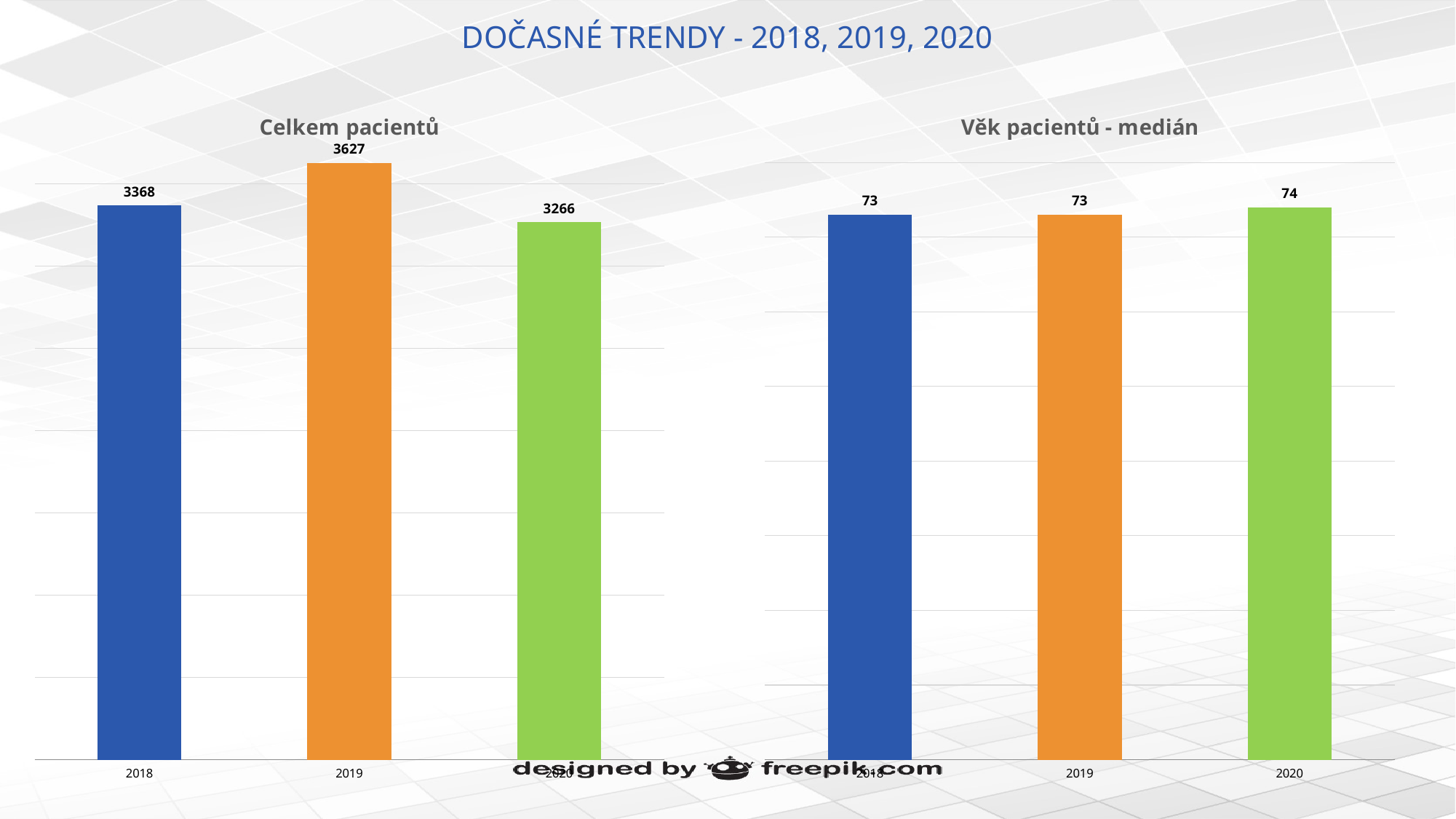
In the 'Celkem pacientů' chart, which year has the highest value? 2019 In the 'Věk pacientů - medián' chart, what is the difference between the 2020 and 2019 values? 1 In the 'Celkem pacientů' chart, which is larger, the value for 2018 or the value for 2020? 2018 In the 'Celkem pacientů' chart, what is the value for 2018? 3368 In the 'Celkem pacientů' chart, what is the value for 2019? 3627 In the 'Celkem pacientů' chart, which year has the lowest value? 2020 How many bars are in the 'Věk pacientů - medián' chart? 3 In the 'Věk pacientů - medián' chart, what is the value for 2018? 73 What is the title of the chart on the right side of the slide? Věk pacientů - medián In the 'Věk pacientů - medián' chart, what is the value for 2020? 74 What type of chart is the 'Celkem pacientů' chart? Bar chart In the 'Celkem pacientů' chart, what is the difference between the 2019 and 2020 values? 361